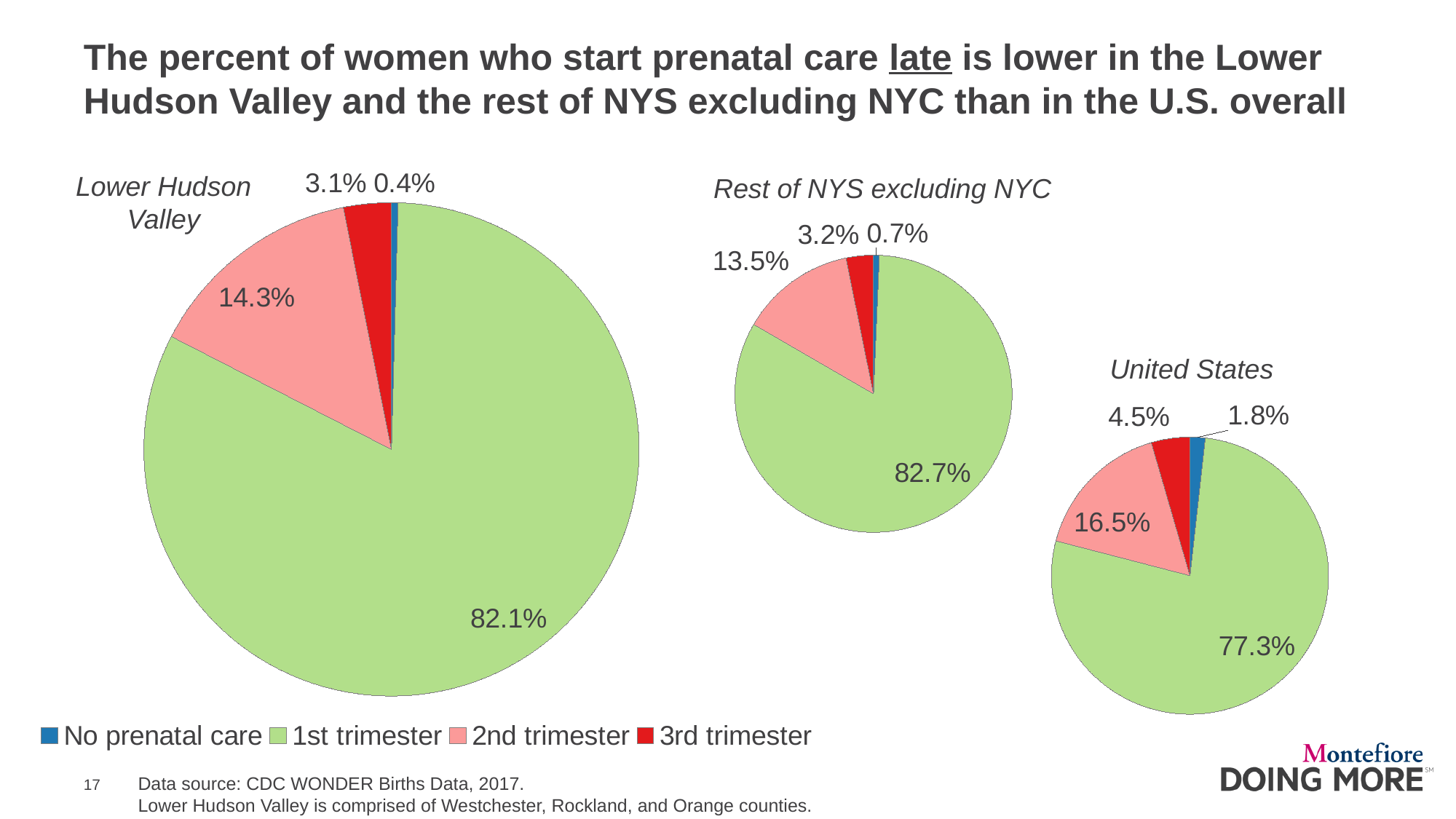
Which is larger: the 2nd trimester share in the Lower Hudson Valley pie chart or the 2nd trimester share in the United States pie chart? United States In the Lower Hudson Valley pie chart, what percent of women had no prenatal care? 0.4% How many categories does the legend list? 4 In the United States pie chart, what percent of women started prenatal care in the 3rd trimester? 4.5% In the Rest of NYS excluding NYC pie chart, which category has the smallest share? No prenatal care In the United States pie chart, which category has the largest share? 1st trimester In the Rest of NYS excluding NYC pie chart, what percent of women started prenatal care in the 2nd trimester? 13.5% In the United States pie chart, what percent of women had no prenatal care? 1.8% What is the difference between the 1st trimester share in the Rest of NYS excluding NYC pie chart and the 1st trimester share in the United States pie chart? 5.4% What type of chart is used to show the prenatal care data on this slide? Pie chart In the Lower Hudson Valley pie chart, what percent of women started prenatal care in the 1st trimester? 82.1% How many pie charts are shown on the slide? 3